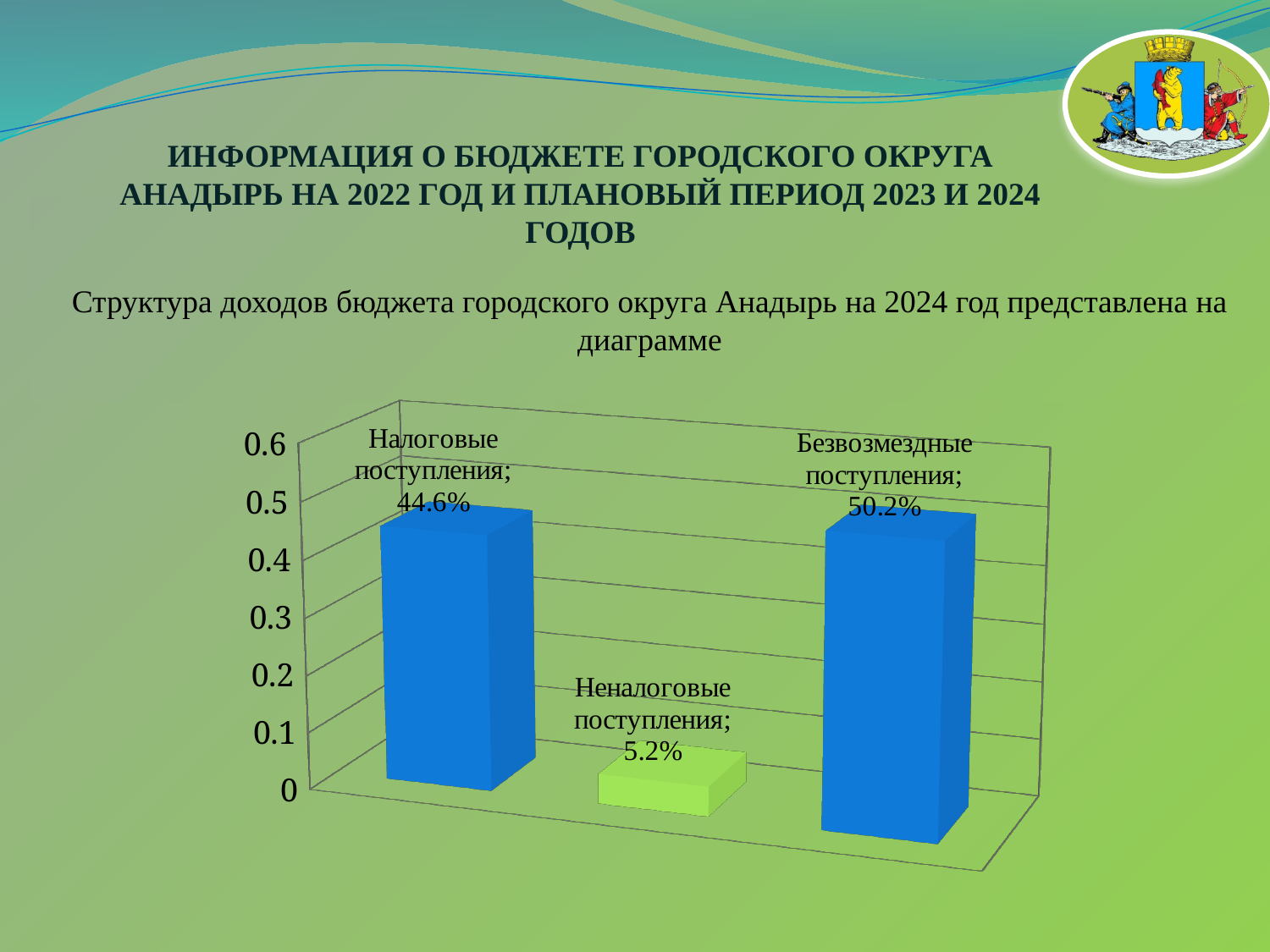
What is the highest tick value shown on the vertical axis? 0.6 What is the value for Налоговые поступления? 44.6% What is the value for Безвозмездные поступления? 50.2% What is the value for Неналоговые поступления? 5.2% What is the difference between Безвозмездные поступления and Налоговые поступления? 5.6% What is the difference between Налоговые поступления and Неналоговые поступления? 39.4% Which category has the lowest value? Неналоговые поступления How many categories are shown in the chart? 3 Is the value for Неналоговые поступления greater or less than 0.1 on the axis? less Which category has the highest value? Безвозмездные поступления What kind of chart is shown on the slide? Bar chart Which is larger, Налоговые поступления or Безвозмездные поступления? Безвозмездные поступления